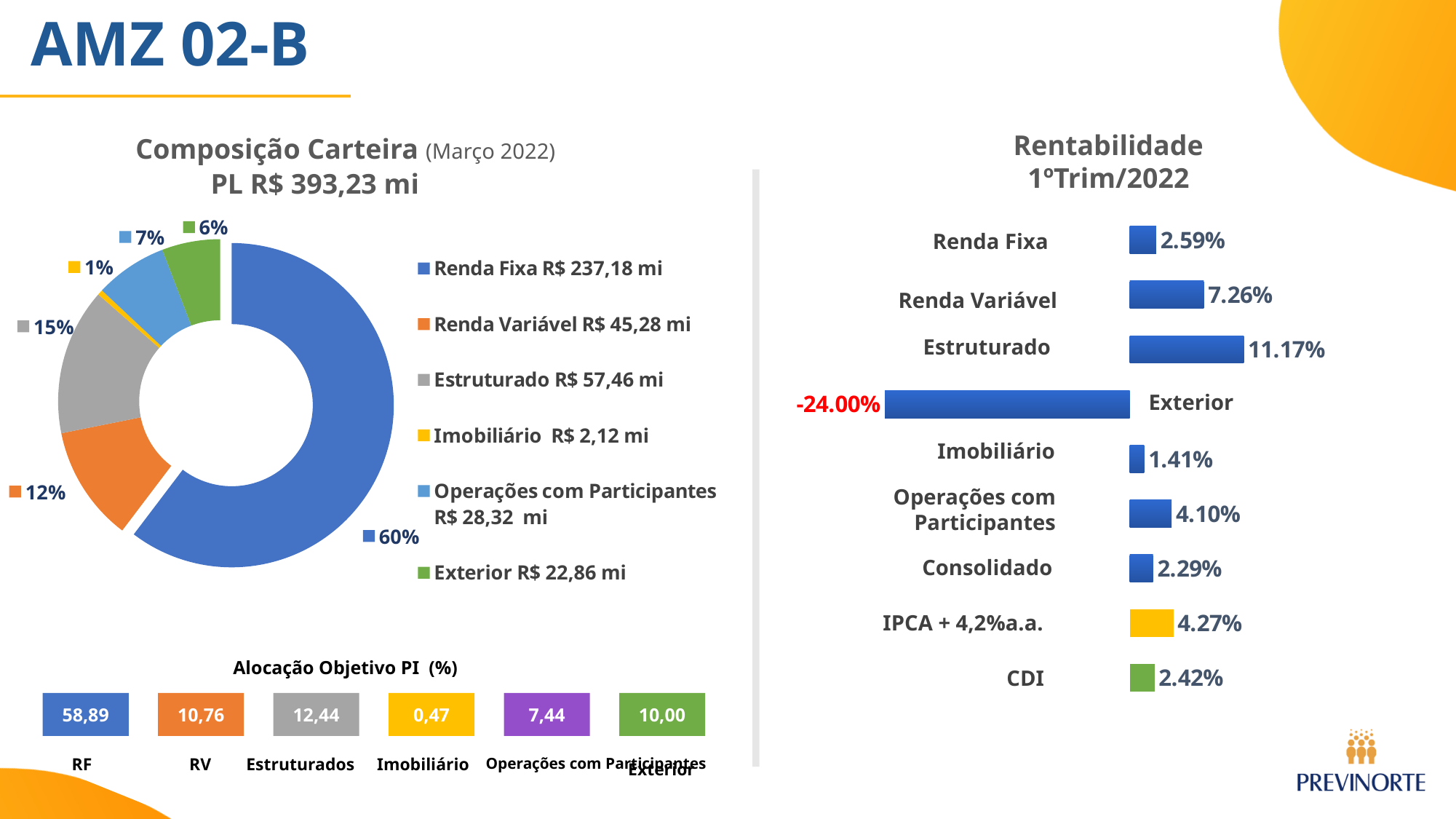
In the Rentabilidade 1ºTrim/2022 chart, what is the difference between Renda Variável and Renda Fixa? 4.67% In the Rentabilidade 1ºTrim/2022 chart, which category has the lowest value? Exterior In the Composição Carteira chart, which category has the smallest slice? Imobiliário In the Composição Carteira chart, which category has the largest slice? Renda Fixa What kind of chart is the Composição Carteira chart? Pie chart (donut) How many categories are shown in the Composição Carteira chart? 6 In the Composição Carteira donut chart, what share of the portfolio is Renda Fixa? 60% In the Rentabilidade 1ºTrim/2022 chart, what is the value for Exterior? -24.00% In the Rentabilidade 1ºTrim/2022 chart, what is the value for Estruturado? 11.17% In the Rentabilidade 1ºTrim/2022 chart, which category has the highest value? Estruturado In the Composição Carteira chart, what value does the legend give for Estruturado? R$ 57,46 mi In the Rentabilidade 1ºTrim/2022 chart, which is larger, IPCA + 4,2%a.a. or CDI? IPCA + 4,2%a.a.